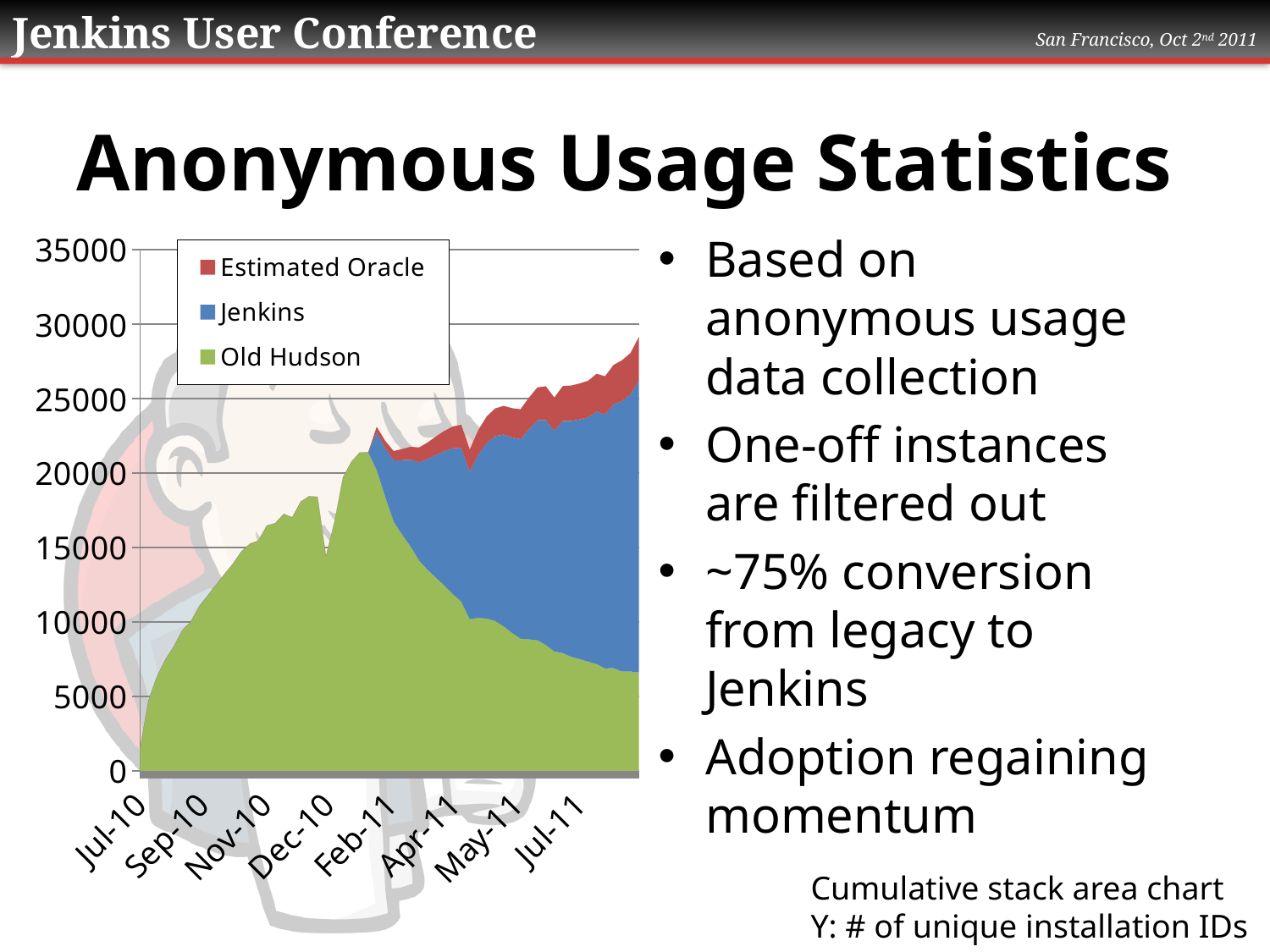
How many series does the chart's legend list? 3 What is the highest value shown on the y axis of the chart? 35000 What kind of chart is shown on the slide? Stacked area chart Does the stacked total rise or fall between Jul-10 and Feb-11? Rise Does the Old Hudson series rise or fall between Feb-11 and Jul-11? Fall Is the value for Old Hudson at Jul-10 greater or less than 5000? less Which series are listed in the chart's legend? Estimated Oracle, Jenkins, Old Hudson Is the value for Old Hudson at Jul-11 greater or less than 10000? less At Jul-11, which series has the larger value, Jenkins or Old Hudson? Jenkins How many date labels are shown on the x axis of the chart? 8 Is the stacked total at Jul-11 greater or less than 25000? greater Which colour represents the Old Hudson series in the chart? Green